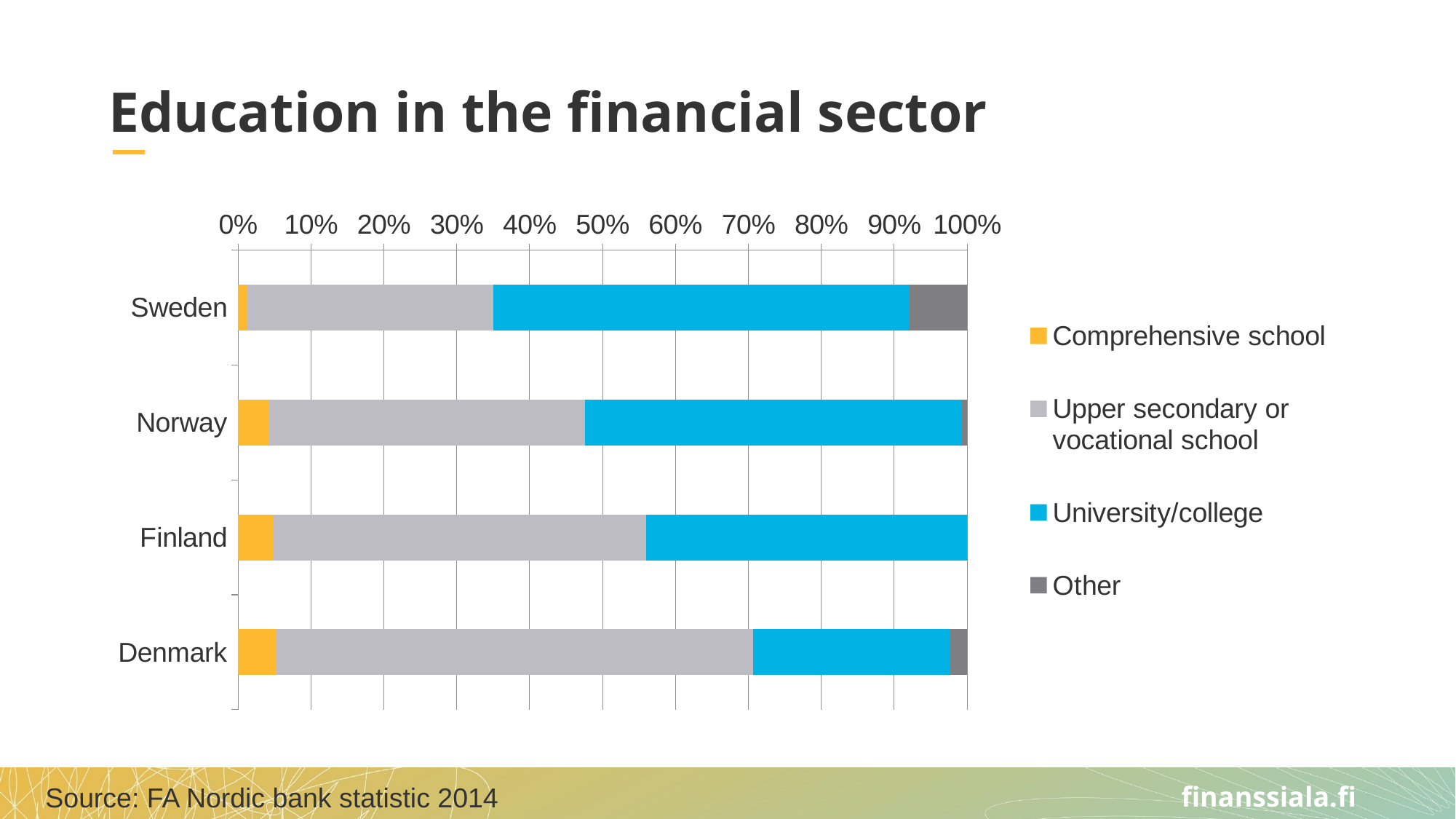
What kind of chart is shown on the slide? Stacked bar chart Is the University/college share for Denmark greater or less than 40%? less For Denmark, which is larger: the Upper secondary or vocational school share or the University/college share? Upper secondary or vocational school Which country has the smallest Comprehensive school share? Sweden How many countries are shown on the chart? 4 How many series does the legend list? 4 Which country has the largest Upper secondary or vocational school share? Denmark Is the University/college share for Sweden greater or less than 50%? greater Which country has the largest Other share? Sweden Which colour represents University/college in the chart? Blue Which country has the largest University/college share? Sweden What is the title of the chart slide? Education in the financial sector